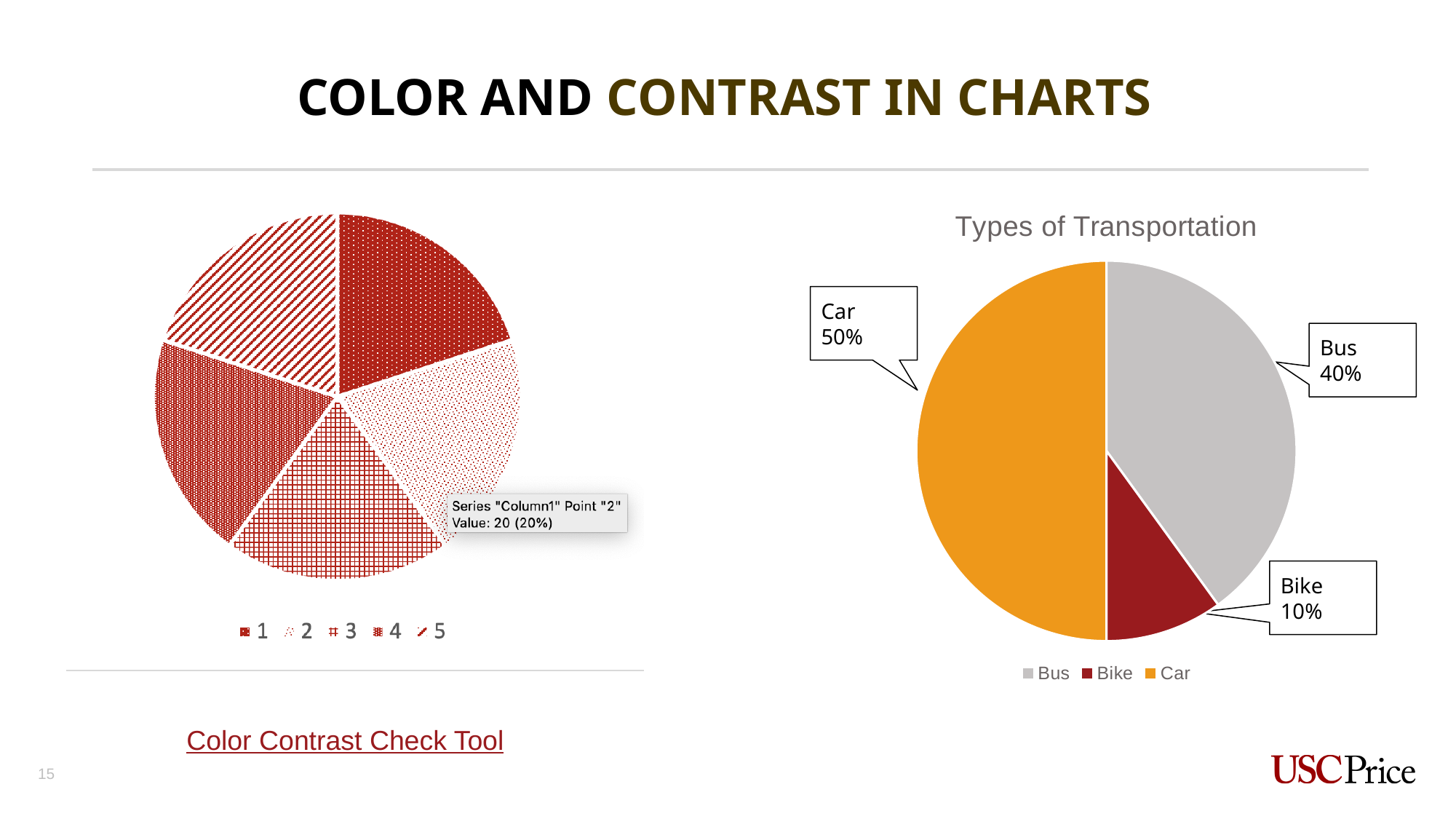
How many categories does the legend of the 'Types of Transportation' chart list? 3 In the 'Types of Transportation' chart, which is larger, Bus or Bike? Bus In the 'Types of Transportation' chart, what percentage is shown for Car? 50% In the 'Types of Transportation' chart, which category has the smallest slice? Bike In the 'Types of Transportation' chart, what colour is the Car slice? Orange What kind of chart is the 'Types of Transportation' chart? Pie chart How many categories does the legend of the patterned pie chart on the left list? 5 In the 'Types of Transportation' chart, what percentage is shown for Bike? 10% In the 'Types of Transportation' chart, what is the difference in percentage points between Car and Bike? 40 In the 'Types of Transportation' chart, what percentage is shown for Bus? 40% In the patterned pie chart on the left, what value does the tooltip show for Point "2"? 20 (20%) In the 'Types of Transportation' chart, which category has the largest slice? Car